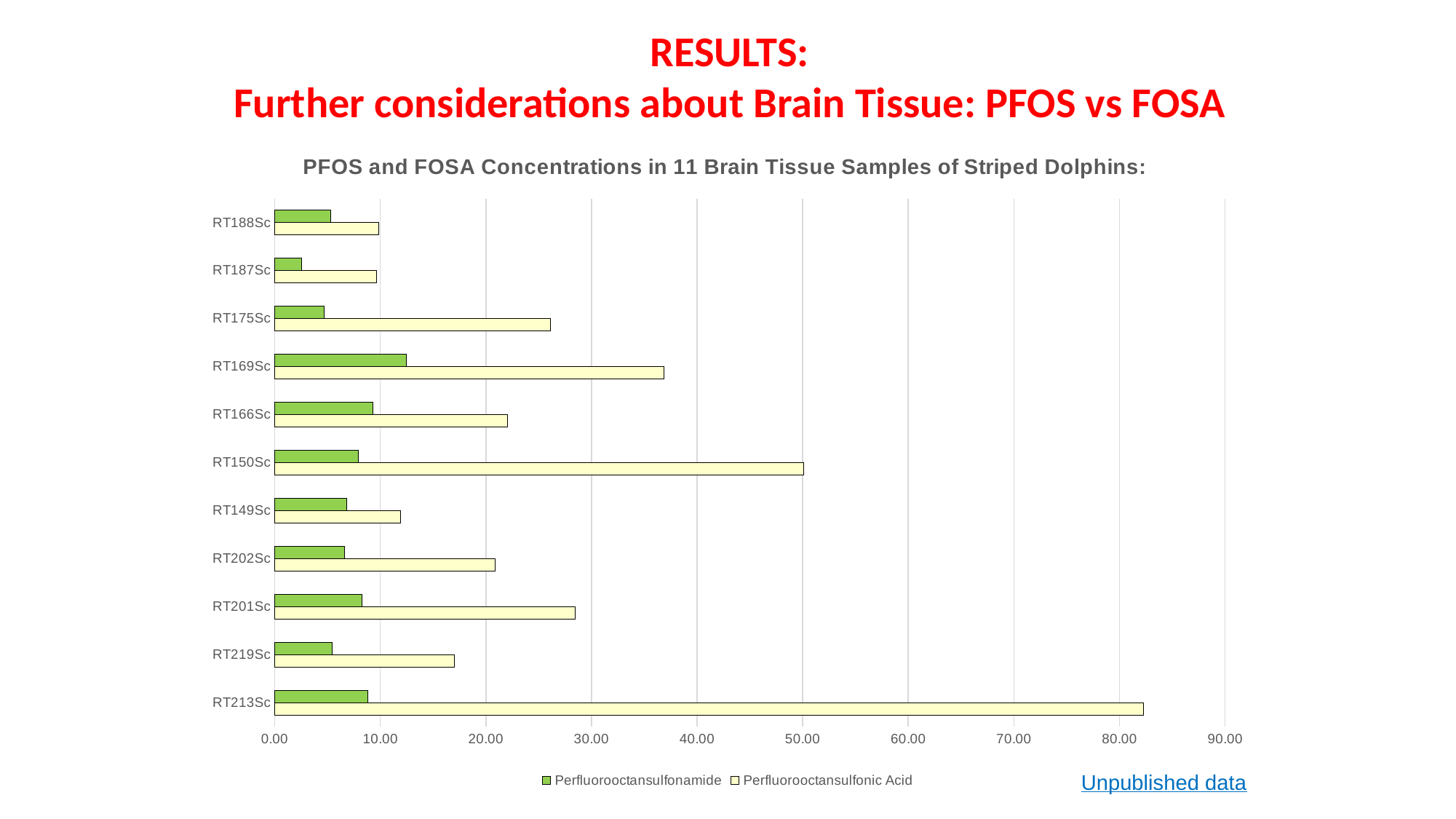
Which sample has the highest Perfluorooctansulfonamide value? RT169Sc How many brain tissue samples are plotted on the chart? 11 Is the Perfluorooctansulfonamide value for RT187Sc greater or less than 10.00? less What kind of chart is shown on the slide? bar chart How many series does the legend list? 2 Which sample has the larger Perfluorooctansulfonic Acid value, RT150Sc or RT169Sc? RT150Sc Which sample has the highest Perfluorooctansulfonic Acid value? RT213Sc Which sample has the larger Perfluorooctansulfonic Acid value, RT175Sc or RT149Sc? RT175Sc Is the Perfluorooctansulfonic Acid value for RT169Sc greater or less than 30.00? greater Is the Perfluorooctansulfonic Acid value for RT213Sc greater or less than 70.00? greater What is the title of the chart? PFOS and FOSA Concentrations in 11 Brain Tissue Samples of Striped Dolphins: Which sample has the lowest Perfluorooctansulfonamide value? RT187Sc